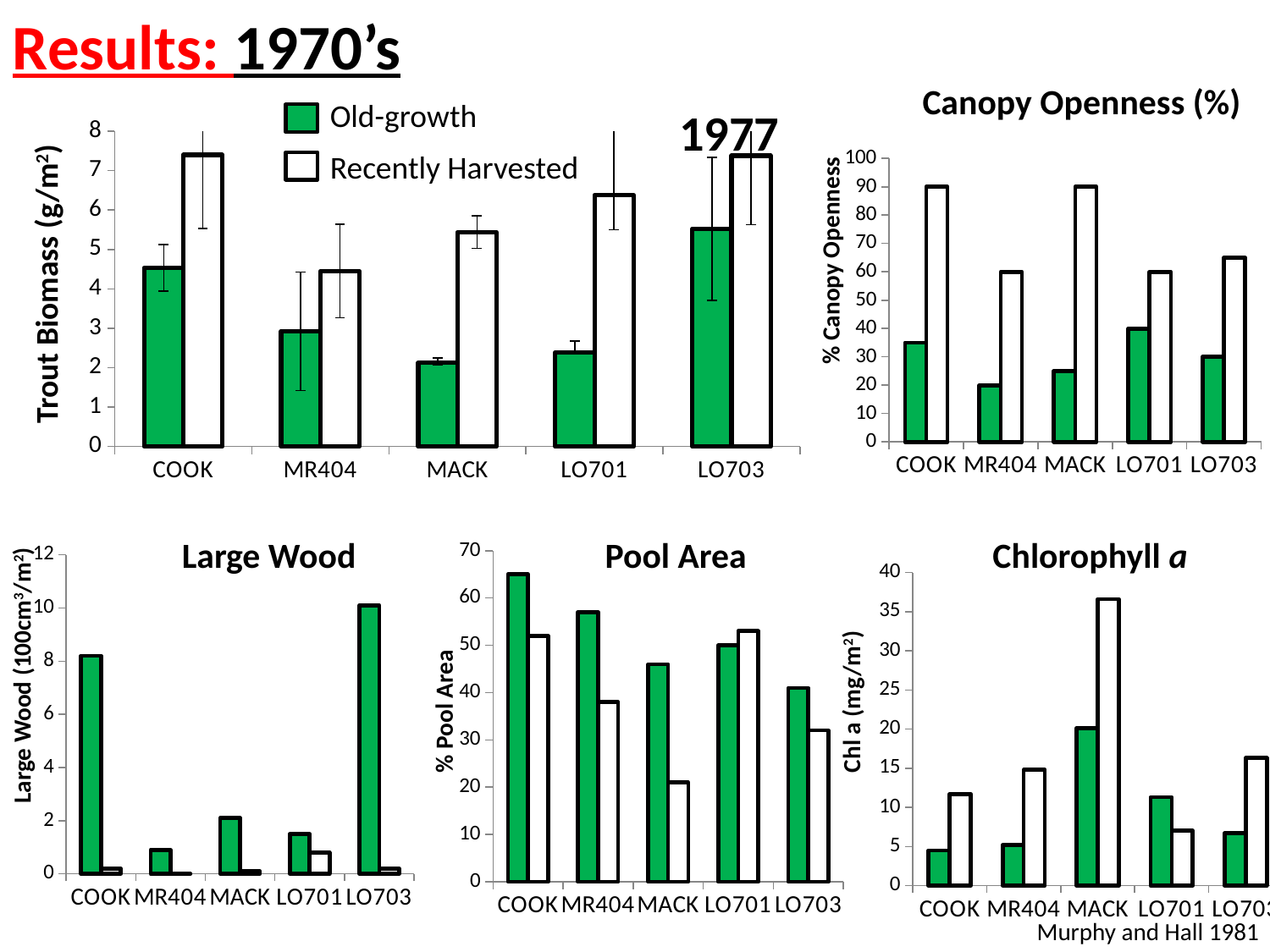
How many series does the legend on the Trout Biomass chart list? 2 On the Chlorophyll a chart, which category has the highest Recently Harvested value? MACK What kind of chart is the Trout Biomass chart at the top left of the slide? bar chart On the Trout Biomass chart, which category has the highest Old-growth value? LO703 On the Pool Area chart, is the Recently Harvested value for MACK greater or less than 30? less On the Canopy Openness (%) chart, is the Recently Harvested value for MR404 greater or less than 50? greater On the Large Wood chart, which category has the highest Old-growth value? LO703 On the Trout Biomass chart, is the Recently Harvested value for COOK greater or less than 7? greater On the Canopy Openness (%) chart, which category has the lowest Old-growth value? MR404 How many stream categories are shown on the x axis of the Trout Biomass chart? 5 What year is printed above the Trout Biomass chart? 1977